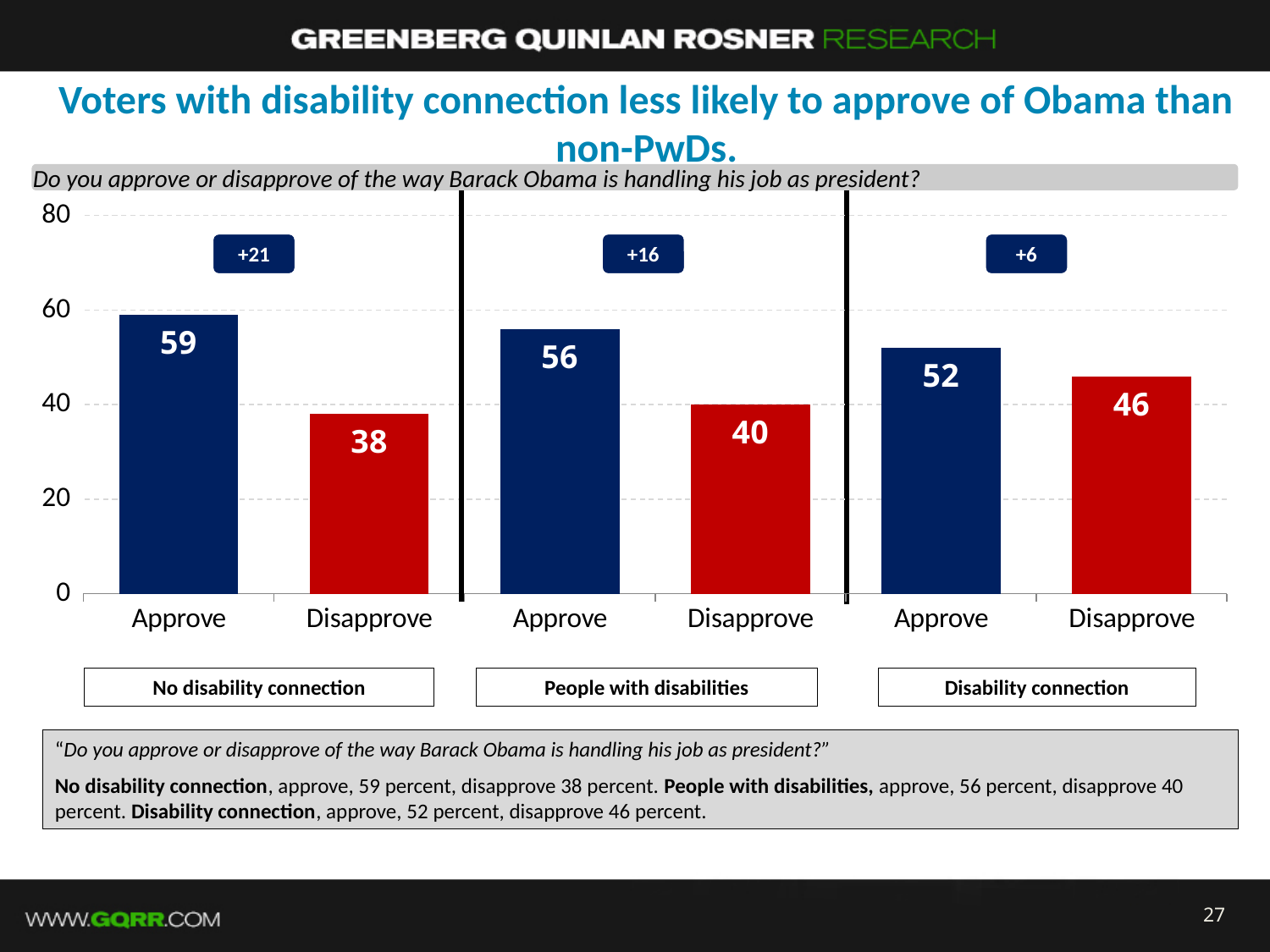
Which group has the highest Approve value? No disability connection What is the difference between the Approve values for No disability connection and People with disabilities? 3 What is the difference between Approve and Disapprove for the Disability connection group? 6 Which group has the lowest Disapprove value? No disability connection What is the Approve value for the No disability connection group? 59 Is the Disapprove value for No disability connection greater or less than 40? less What label is shown in the box above the People with disabilities bars? +16 What is the Disapprove value for People with disabilities? 40 How many bars are plotted on the chart? 6 What is the Approve value for the Disability connection group? 52 Which is larger: Disapprove for Disability connection or Disapprove for People with disabilities? Disapprove for Disability connection What kind of chart is shown on the slide? bar chart